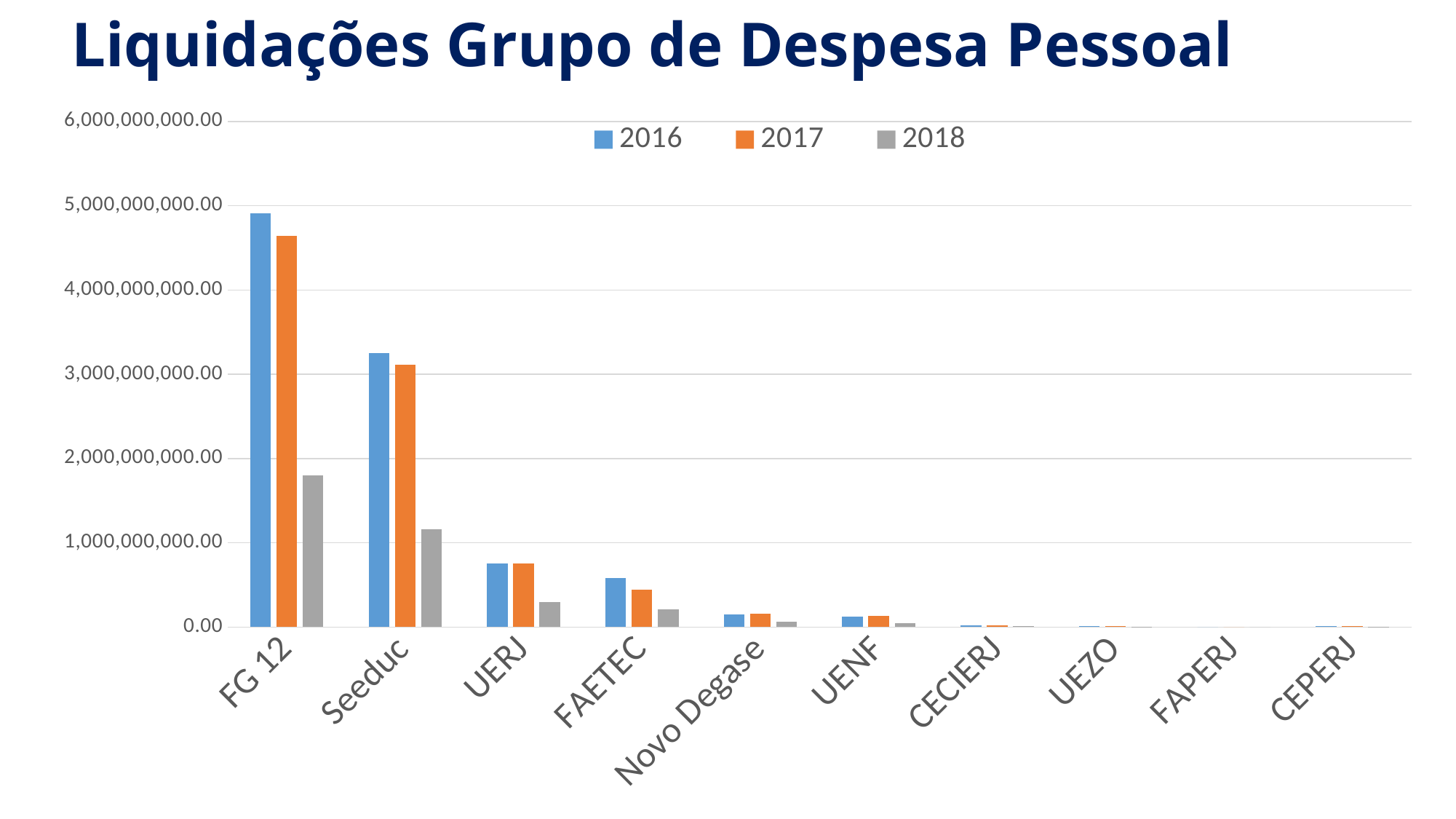
Is the 2016 value for FG 12 greater or less than 4,000,000,000.00? greater What is the title of the chart? Liquidações Grupo de Despesa Pessoal Is the 2016 value for Seeduc greater or less than 3,000,000,000.00? greater Which category has the highest value for 2016? FG 12 Which category has the highest value for 2018? FG 12 How many series does the legend list? 3 Is the 2016 value for UERJ greater or less than 1,000,000,000.00? less How many categories are shown on the x axis? 10 What kind of chart is shown on the slide? bar chart For FAETEC, which is larger: the 2016 value or the 2018 value? 2016 For FG 12, which is larger: the 2016 value or the 2017 value? 2016